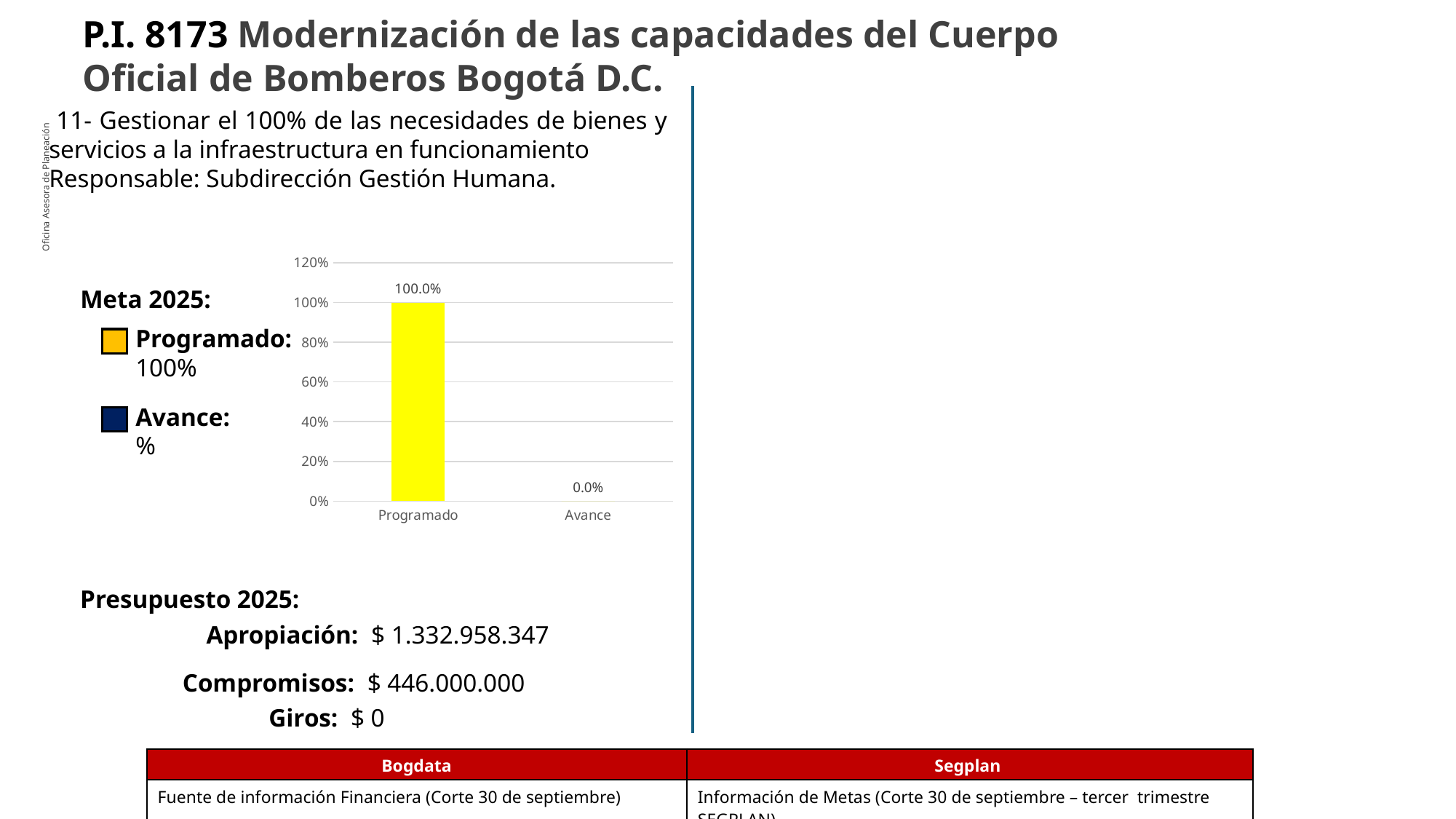
Which category has the lowest value in the chart? Avance What is the difference between the Programado and Avance values in the chart? 100.0% What is the highest tick value shown on the chart's y axis? 120% What is the value shown for Programado in the chart? 100.0% What colour is the Programado bar in the chart? Yellow Which category has the highest value in the chart? Programado What kind of chart is shown on the slide? Bar chart What is the value shown for Avance in the chart? 0.0% Which is larger in the chart, Programado or Avance? Programado How many categories are shown on the x axis of the chart? 2 Is the value for Avance greater or less than 20%? less Is the value for Programado greater or less than 80%? greater